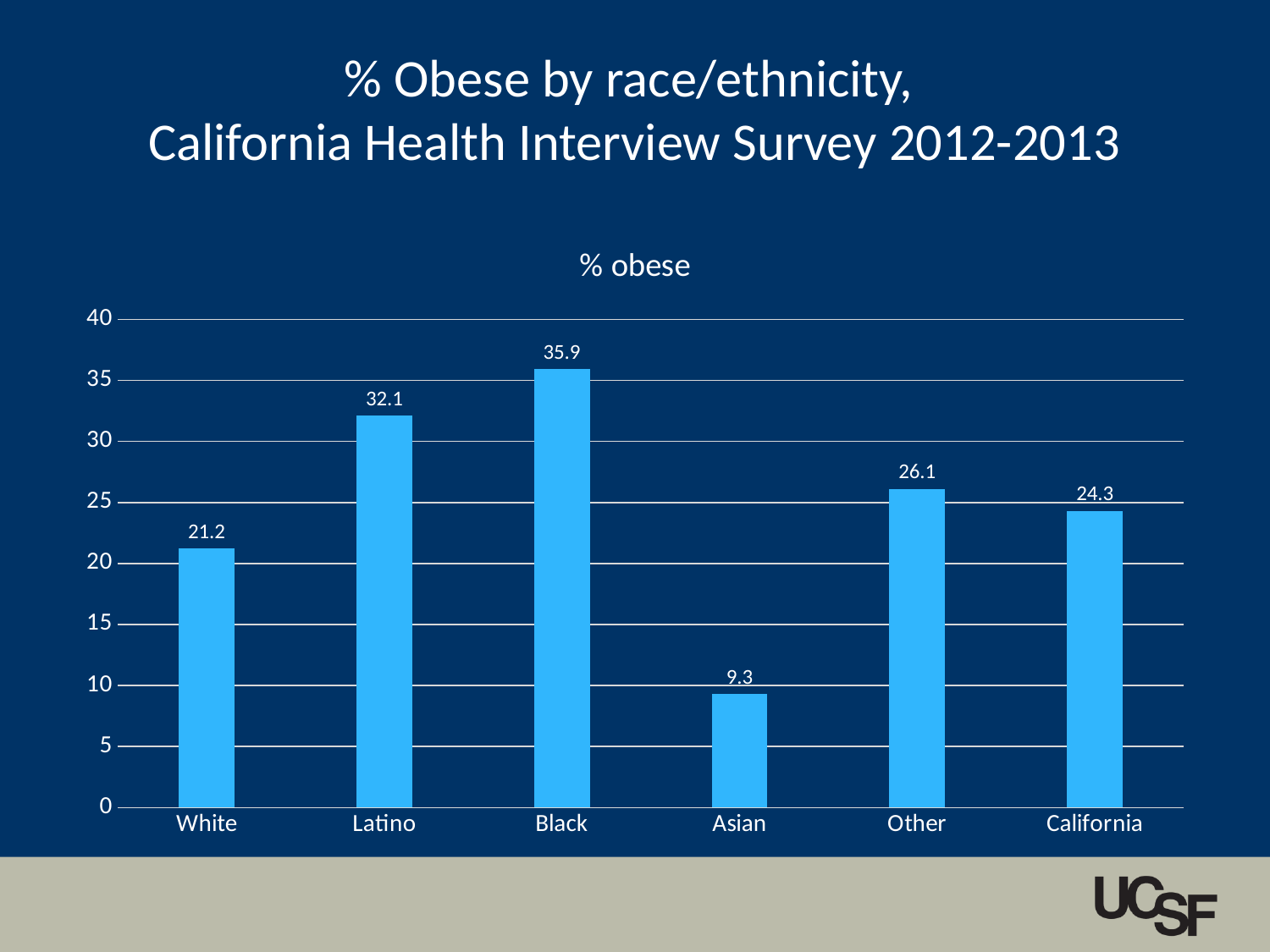
How many categories are shown on the x axis? 6 What is the % obese value for Asian? 9.3 Which has a higher % obese, Other or California? Other Is the value for Latino greater or less than 30? greater What is the difference in % obese between Latino and White? 10.9 Which category has the lowest % obese? Asian What is the % obese value for California? 24.3 Which category has the highest % obese? Black What kind of chart is shown on the slide? bar chart What is the title of the chart? % obese What is the % obese value for Black? 35.9 What is the difference in % obese between Black and Asian? 26.6